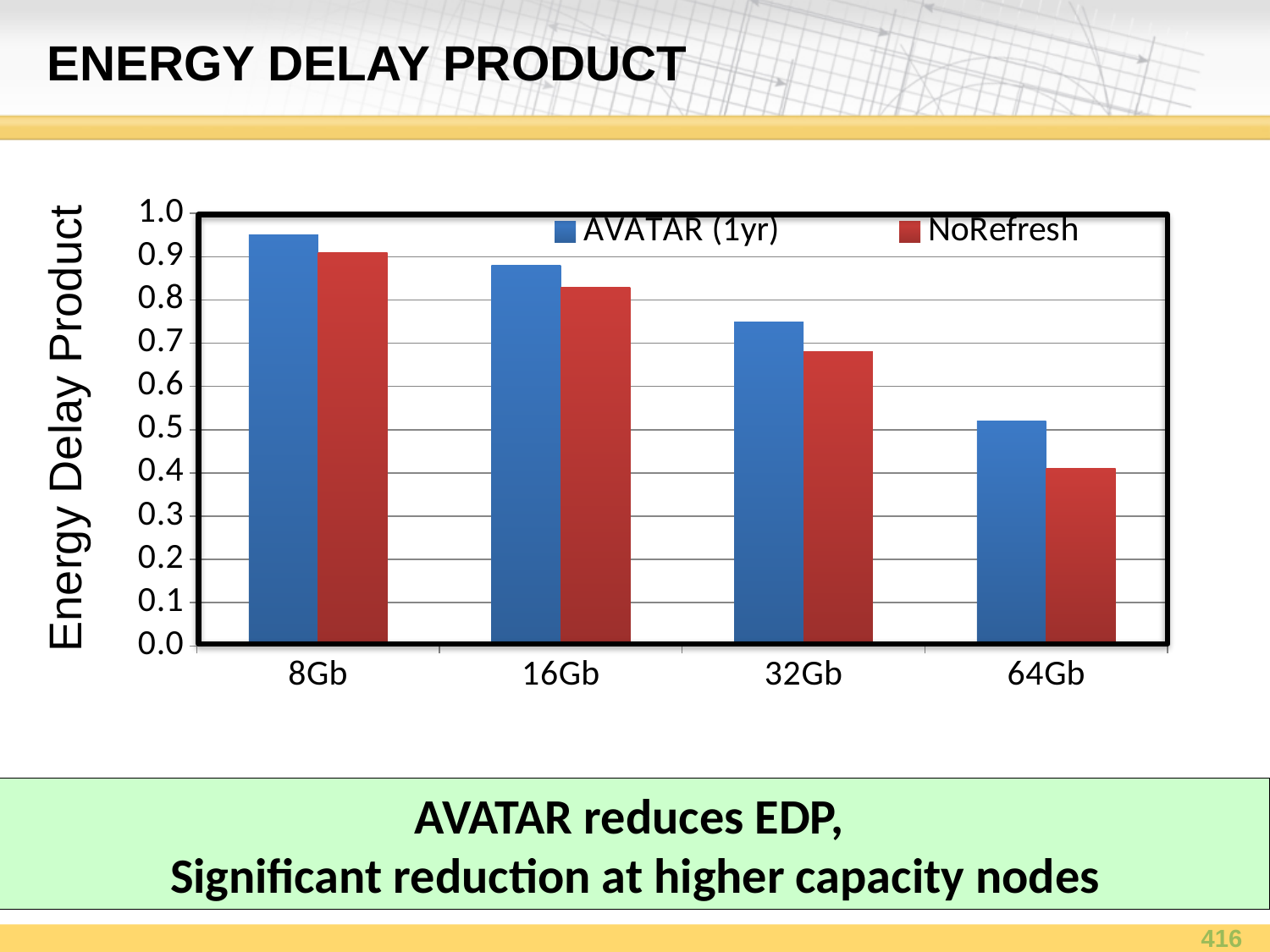
What kind of chart is shown on the slide? bar chart Is the AVATAR (1yr) value for 32Gb greater or less than 0.7? greater What is the label on the y axis? Energy Delay Product Which capacity has the lowest NoRefresh value? 64Gb At 64Gb, which is larger: AVATAR (1yr) or NoRefresh? AVATAR (1yr) How many capacity categories are shown on the x axis? 4 Which capacity has the highest AVATAR (1yr) value? 8Gb Is the AVATAR (1yr) value for 8Gb greater or less than 0.9? greater How many series does the legend list? 2 Is the AVATAR (1yr) value for 16Gb greater or less than 0.8? greater Do the NoRefresh values rise or fall as capacity increases from 8Gb to 64Gb? fall